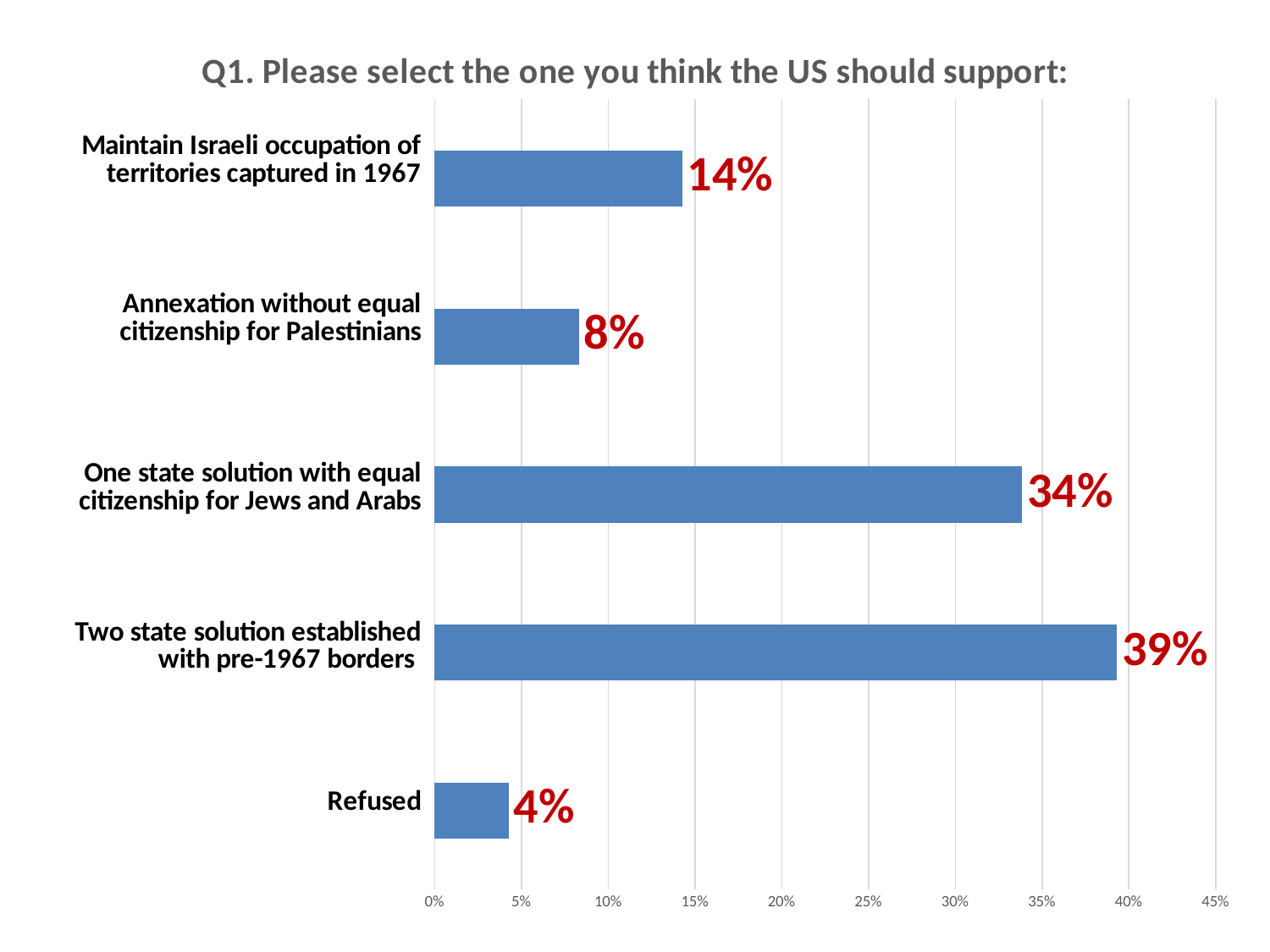
Which is larger: the value for "Maintain Israeli occupation of territories captured in 1967" or for "Annexation without equal citizenship for Palestinians"? Maintain Israeli occupation of territories captured in 1967 Is the value for "One state solution with equal citizenship for Jews and Arabs" greater or less than 30%? greater What is the difference between the values for "Maintain Israeli occupation of territories captured in 1967" and "Refused"? 10% What type of chart is shown on the slide? bar chart What is the difference between the values for "Two state solution established with pre-1967 borders" and "One state solution with equal citizenship for Jews and Arabs"? 5% Which option has the highest percentage? Two state solution established with pre-1967 borders What percentage of respondents selected "Two state solution established with pre-1967 borders"? 39% What percentage is shown for "Refused"? 4% How many categories are shown in the chart? 5 What is the value for "Annexation without equal citizenship for Palestinians"? 8% Which category has the lowest value? Refused What is the title of the chart? Q1. Please select the one you think the US should support: